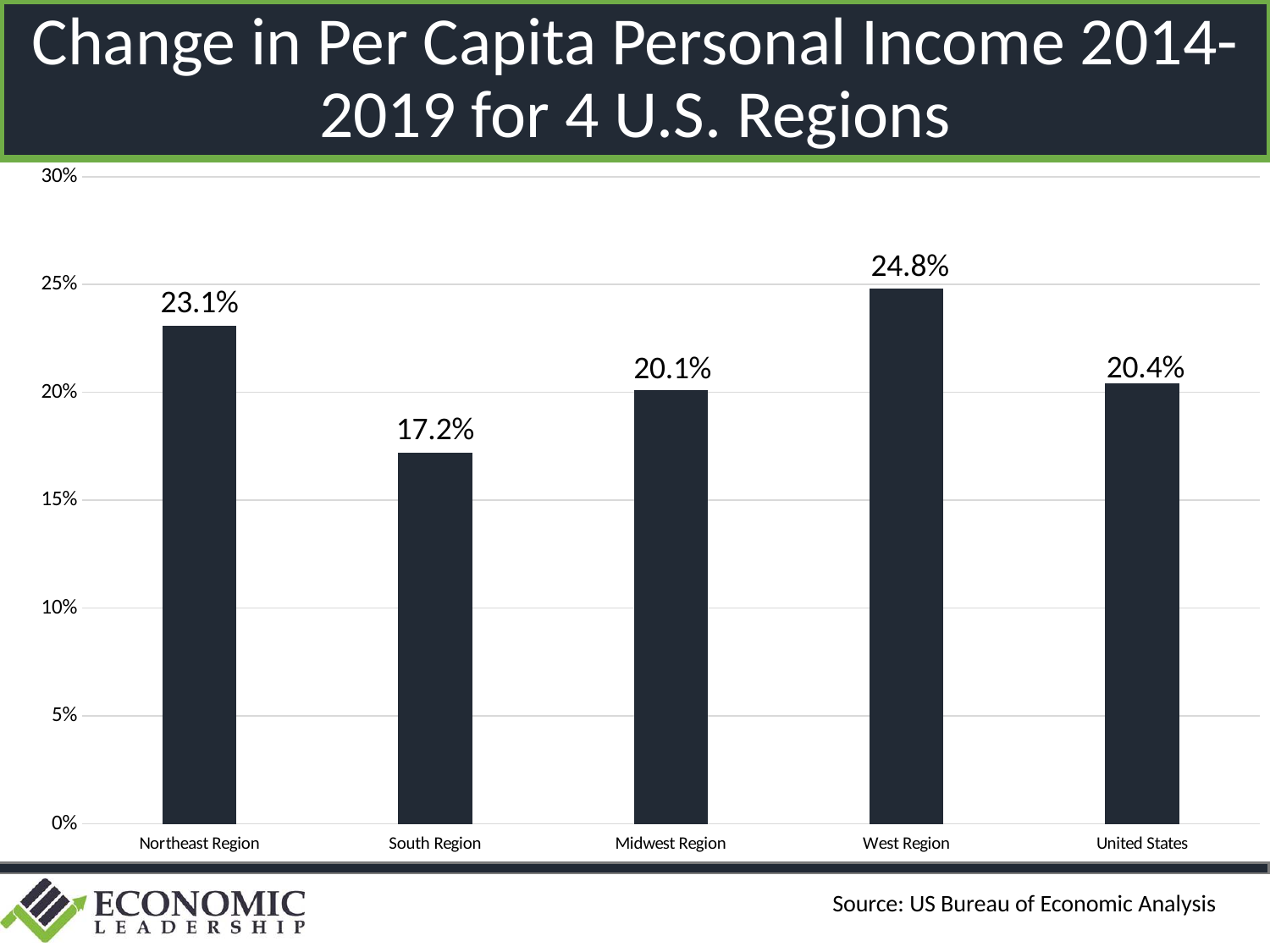
Which category has the lowest change in per capita personal income? South Region Is the value for the South Region greater or less than 20%? less What kind of chart is shown on the slide? Bar chart How many categories are shown on the x axis? 5 What is the source cited for the chart data? US Bureau of Economic Analysis What is the change in per capita personal income for the South Region? 17.2% What is the change in per capita personal income for the Northeast Region? 23.1% Which category has the highest change in per capita personal income? West Region What is the value shown for the United States? 20.4% What is the difference between the West Region and the South Region values? 7.6% Which is larger, the value for the Midwest Region or the Northeast Region? Northeast Region What is the difference between the Northeast Region and the United States values? 2.7%